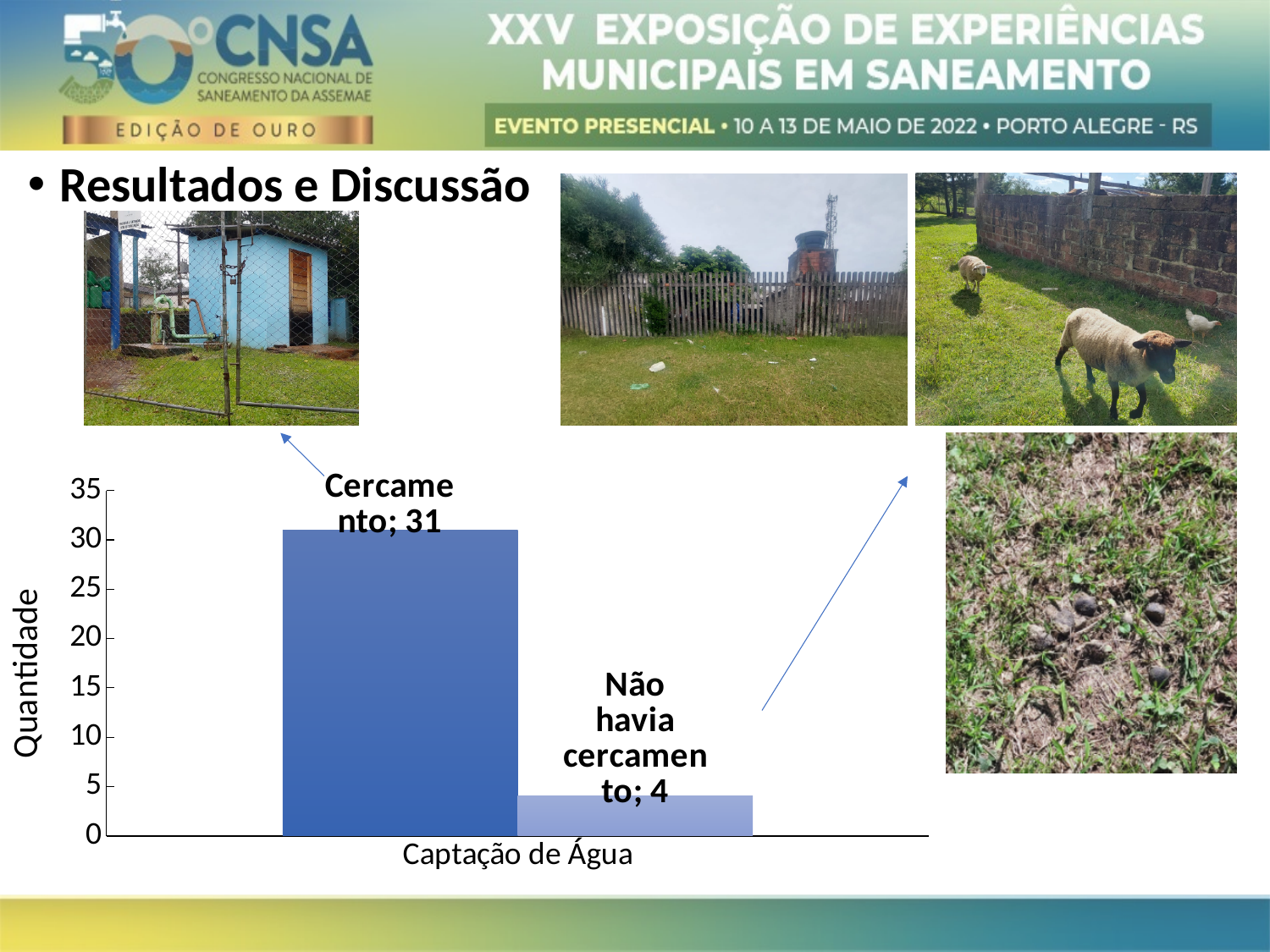
What is the label on the vertical axis of the chart? Quantidade Is the value for Não havia cercamento greater or less than 5? less Is the value for Cercamento greater or less than 30? greater Which series has the highest value in the chart? Cercamento What is the value for Não havia cercamento in the chart? 4 What is the category label on the horizontal axis of the chart? Captação de Água What is the value for Cercamento in the chart? 31 Which series has the lowest value in the chart? Não havia cercamento Which is larger, the value for Cercamento or for Não havia cercamento? Cercamento What is the difference between the values for Cercamento and Não havia cercamento? 27 How many bars are plotted in the chart? 2 What kind of chart is shown on the slide? Bar chart